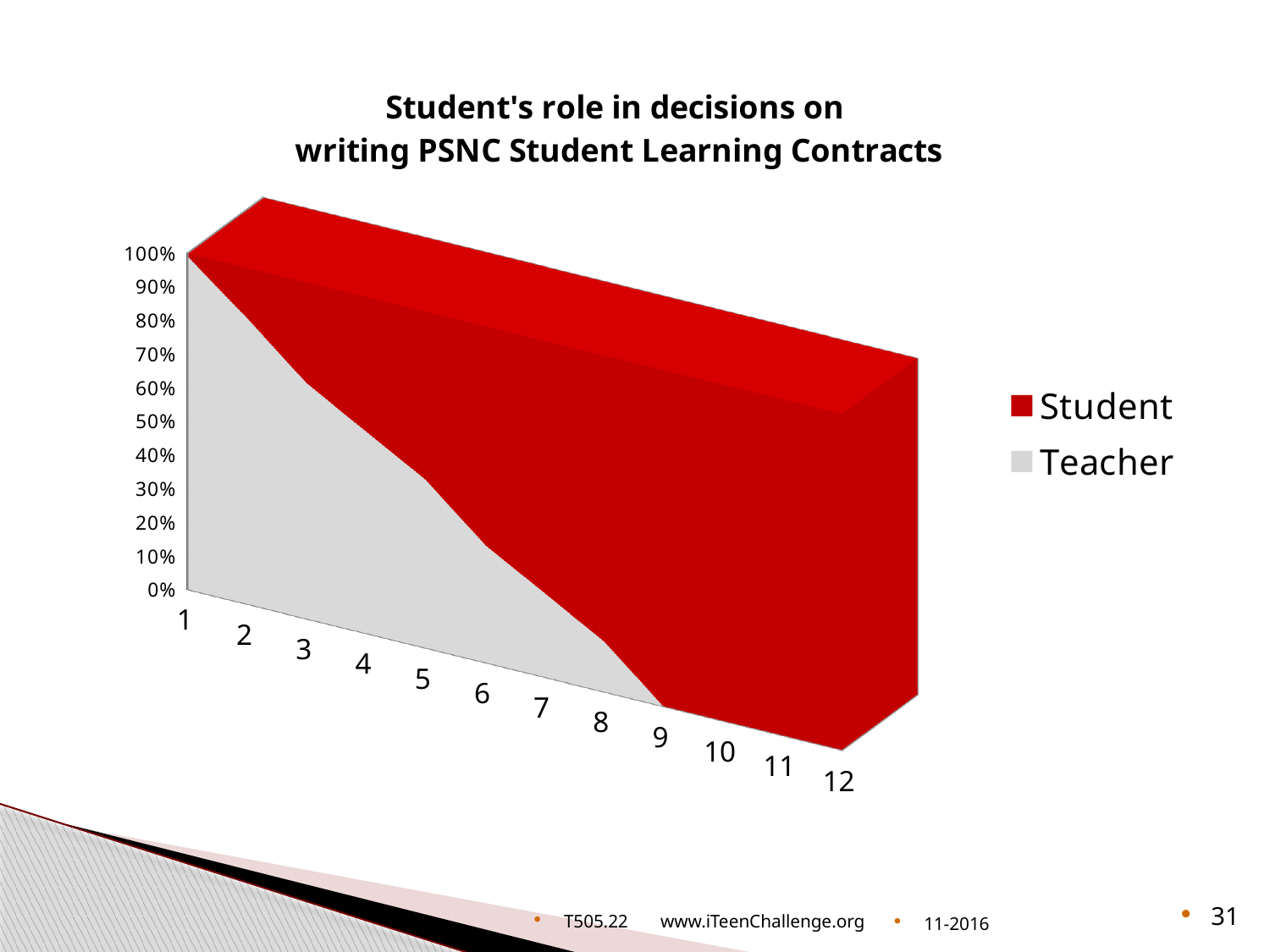
Is the Teacher value at category 2 greater or less than 50%? greater Which colour represents the Teacher series? grey At category 12, which series has the larger share, Student or Teacher? Student How many series does the legend list? 2 Is the Teacher value at category 8 greater or less than 50%? less Is the Student value at category 12 greater or less than 90%? greater How many categories are shown along the x axis? 12 What kind of chart is shown on the slide? area chart At category 1, which series has the larger share, Student or Teacher? Teacher Does the Student share rise or fall as the categories go from 1 to 12? rise What is the title of the chart? Student's role in decisions on writing PSNC Student Learning Contracts Does the Teacher share rise or fall as the categories go from 1 to 12? fall